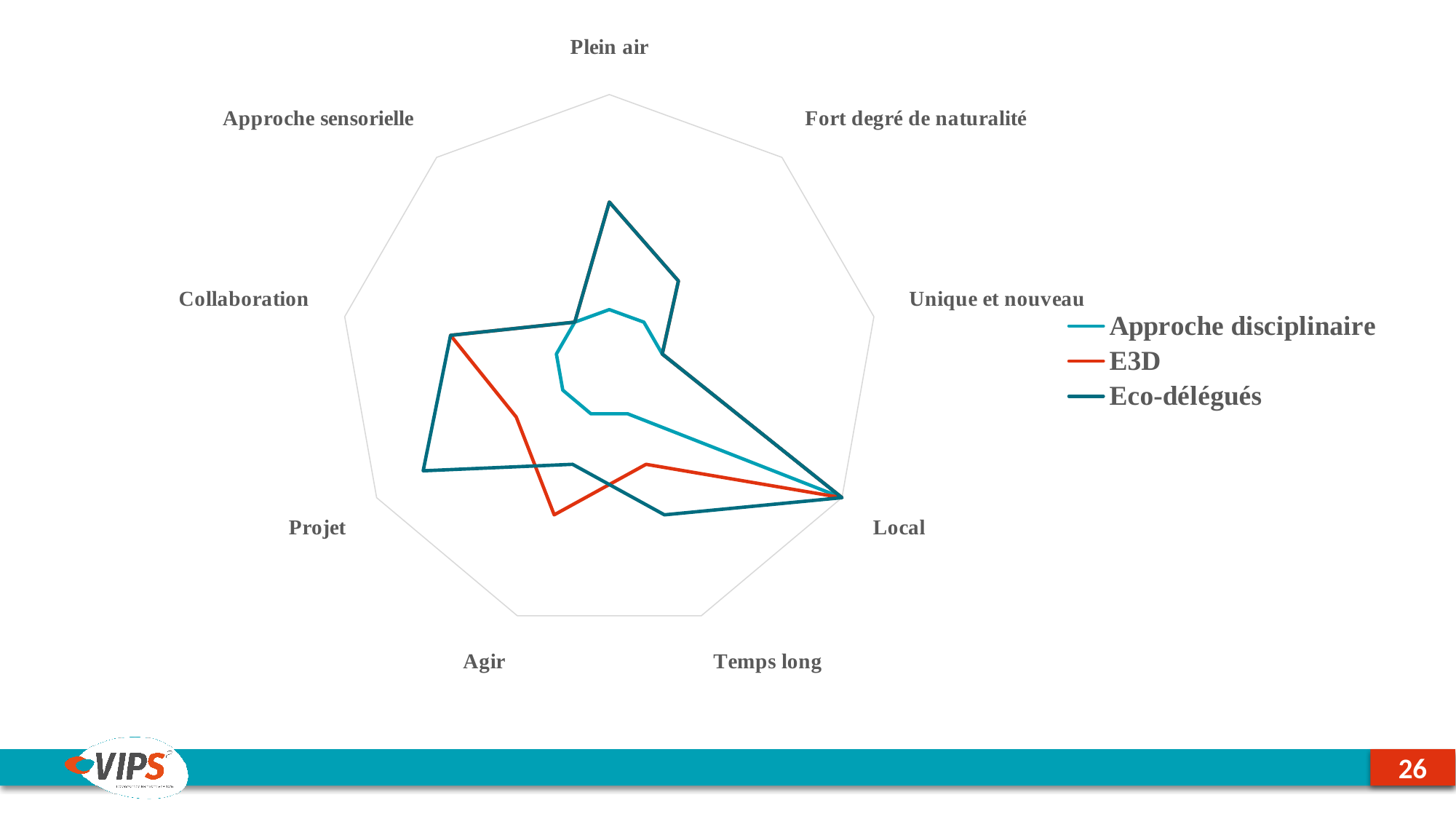
On the Plein air axis, which series has the larger value, Approche disciplinaire or Eco-délégués? Eco-délégués On the Agir axis, which series has the highest value? E3D What colour is the line for the E3D series? red How many series does the legend list? 3 On which axis does the Eco-délégués series reach its highest value? Local Which series are listed in the legend? Approche disciplinaire, E3D, Eco-délégués On the Projet axis, which series has the larger value, E3D or Eco-délégués? Eco-délégués On the Agir axis, which series has the larger value, E3D or Eco-délégués? E3D What kind of chart is shown on the slide? radar chart On which axis does the Approche disciplinaire series reach its highest value? Local How many category axes does the radar chart have? 9